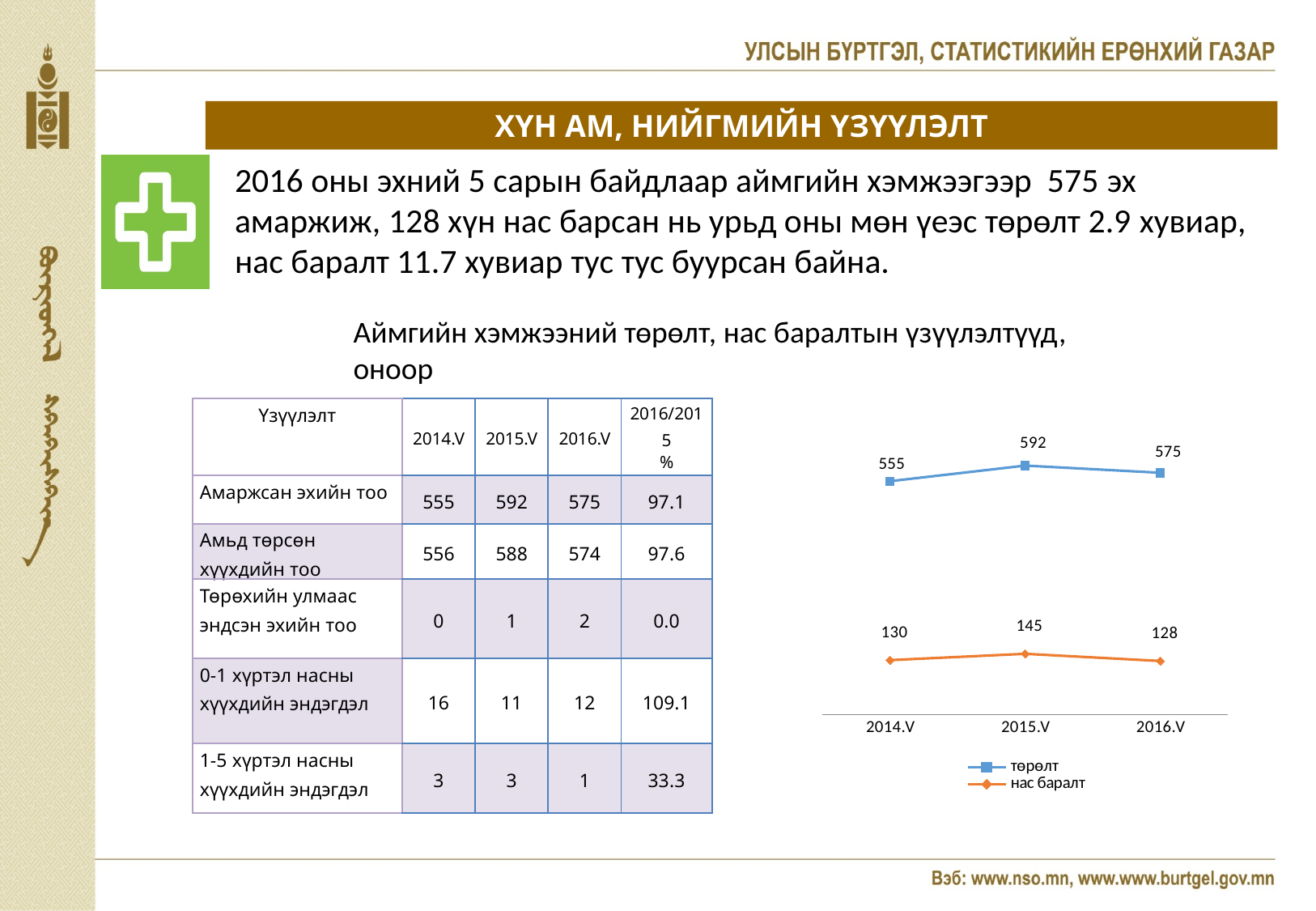
What is the value of нас баралт for 2016.V? 128 What is the difference between төрөлт in 2015.V and 2016.V? 17 What type of chart is shown on the slide? line chart In which period is нас баралт lowest? 2016.V What is the difference between нас баралт in 2015.V and 2014.V? 15 In which period is төрөлт highest? 2015.V What is the value of төрөлт for 2015.V? 592 How many periods are plotted on the x axis of the chart? 3 Which is larger: төрөлт in 2016.V or төрөлт in 2014.V? 2016.V How many series does the chart legend list? 2 Which series is drawn in orange in the chart? нас баралт What is the value of төрөлт for 2014.V? 555